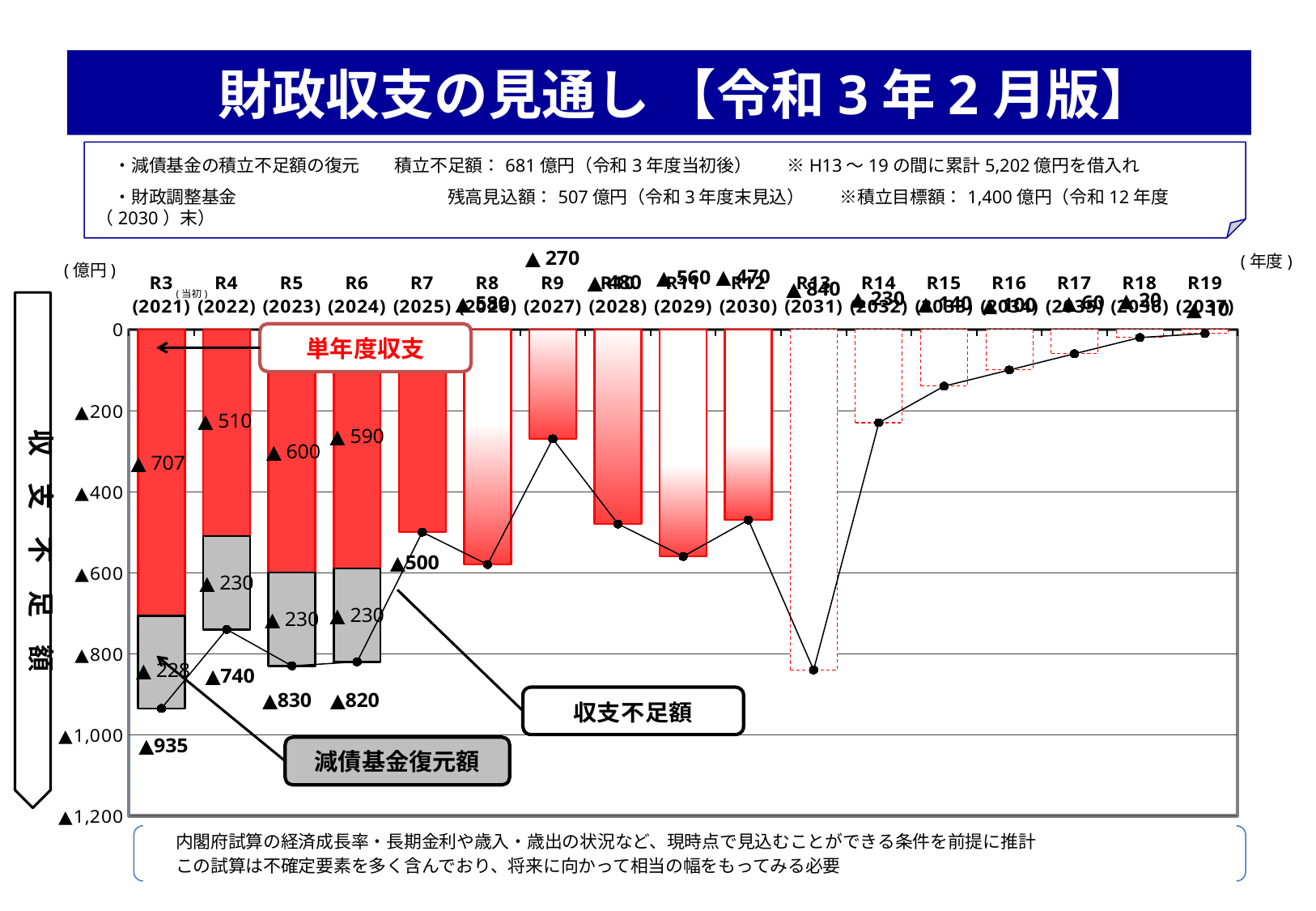
What is the 収支不足額 value for R13 (2031)? ▲840 Which year has the largest 収支不足額? R3 (2021) Which year has a larger 収支不足額, R9 (2027) or R11 (2029)? R11 (2029) What is the 単年度収支 value for R3 (2021)? ▲707 Which year has the smallest 収支不足額? R19 (2037) From R13 (2031) to R19 (2037), does the 収支不足額 rise or fall? Fall What kind of chart is this? Bar chart with a line What is the 収支不足額 value for R3 (2021)? ▲935 How many fiscal years are shown on the x axis? 17 What is the 収支不足額 value for R7 (2025)? ▲500 What is the 減債基金復元額 value for R4 (2022)? ▲230 What is the difference between the 収支不足額 for R3 (2021) and R4 (2022)? 195